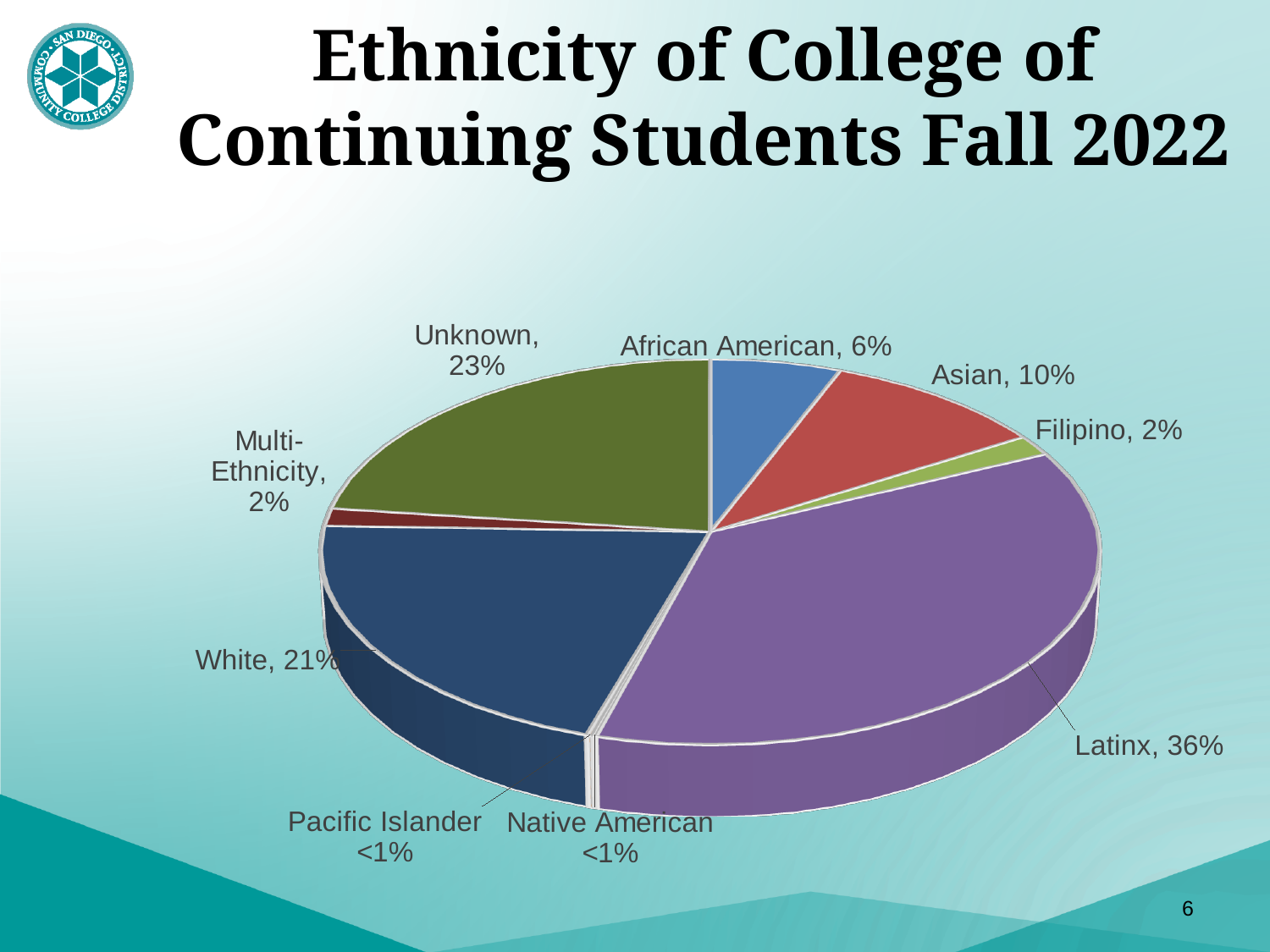
Which is larger, the share for White or the share for Unknown? Unknown What percentage of continuing students is listed as Unknown ethnicity? 23% What kind of chart is shown on the slide? pie chart What is the difference in percentage points between the Asian share and the African American share? 4 How many ethnicity categories are shown in the pie chart? 9 What is the difference in percentage points between the Latinx share and the White share? 15 What percentage is shown for African American students? 6% Which ethnicity has the largest share of the pie? Latinx What share is shown for Filipino students? 2% What share of continuing students is Latinx? 36% What share of continuing students is Asian? 10% What is the title of the slide containing the pie chart? Ethnicity of College of Continuing Students Fall 2022